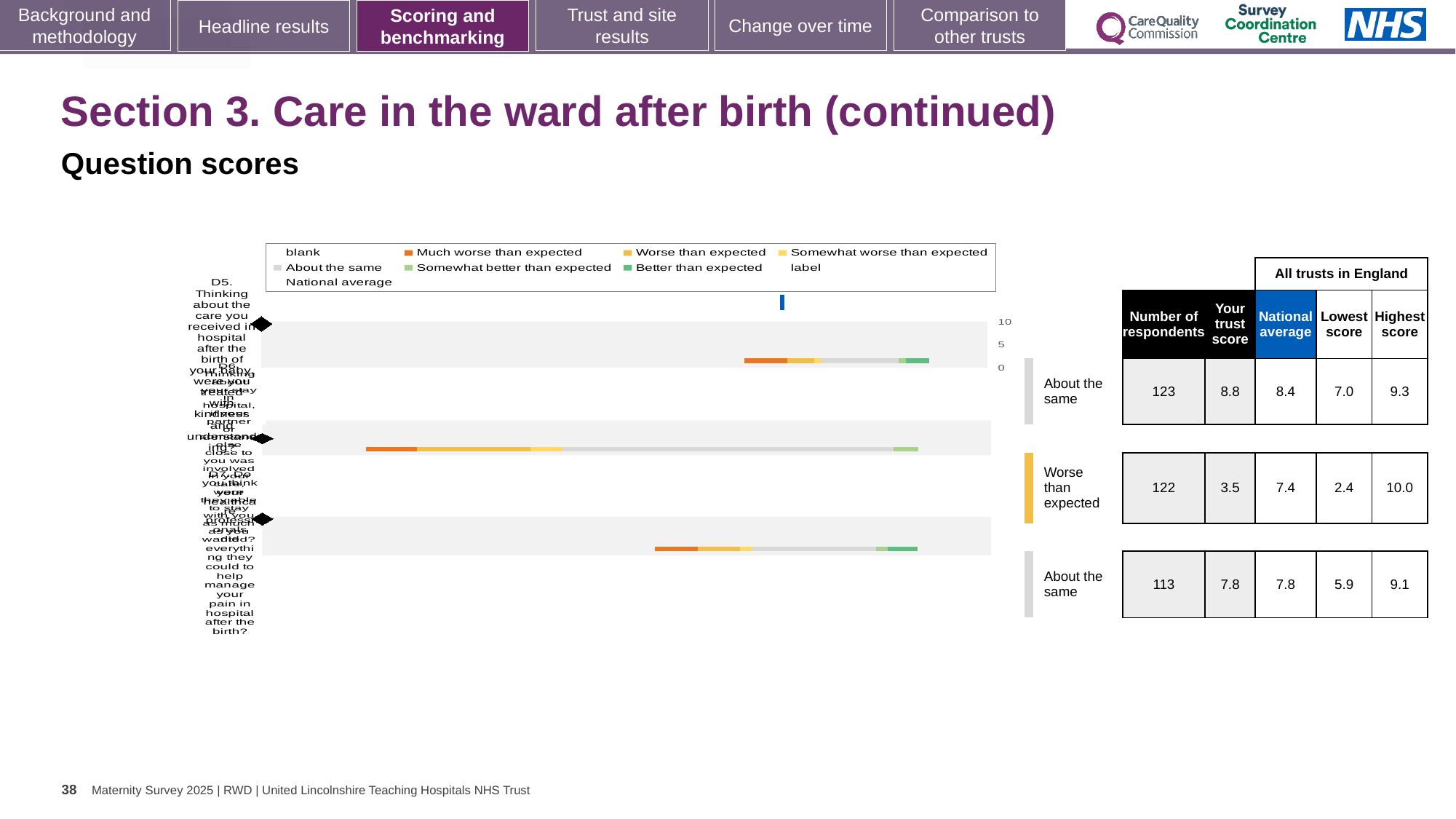
In the table, what is the number of respondents for the first row (rated 'About the same')? 123 Which legend entry is shown in orange? Much worse than expected What kind of chart is shown on the slide? bar chart In the table, what is the national average for the row with 113 respondents? 7.8 In the table, what is the highest score in England for the row rated 'Worse than expected'? 10.0 How many question rows (bars) are plotted in the chart? 3 In the table, what is 'Your trust score' for the second row (rated 'Worse than expected')? 3.5 In the first row of the table, is 'Your trust score' higher or lower than the national average? higher Which row has the highest 'Your trust score' in the table? the first row (8.8) For the row rated 'Worse than expected', what is the difference between the national average and your trust score? 3.9 What is the highest value shown on the chart's score axis? 10 Which row has the lowest 'Lowest score' value in the table? the second row (2.4)